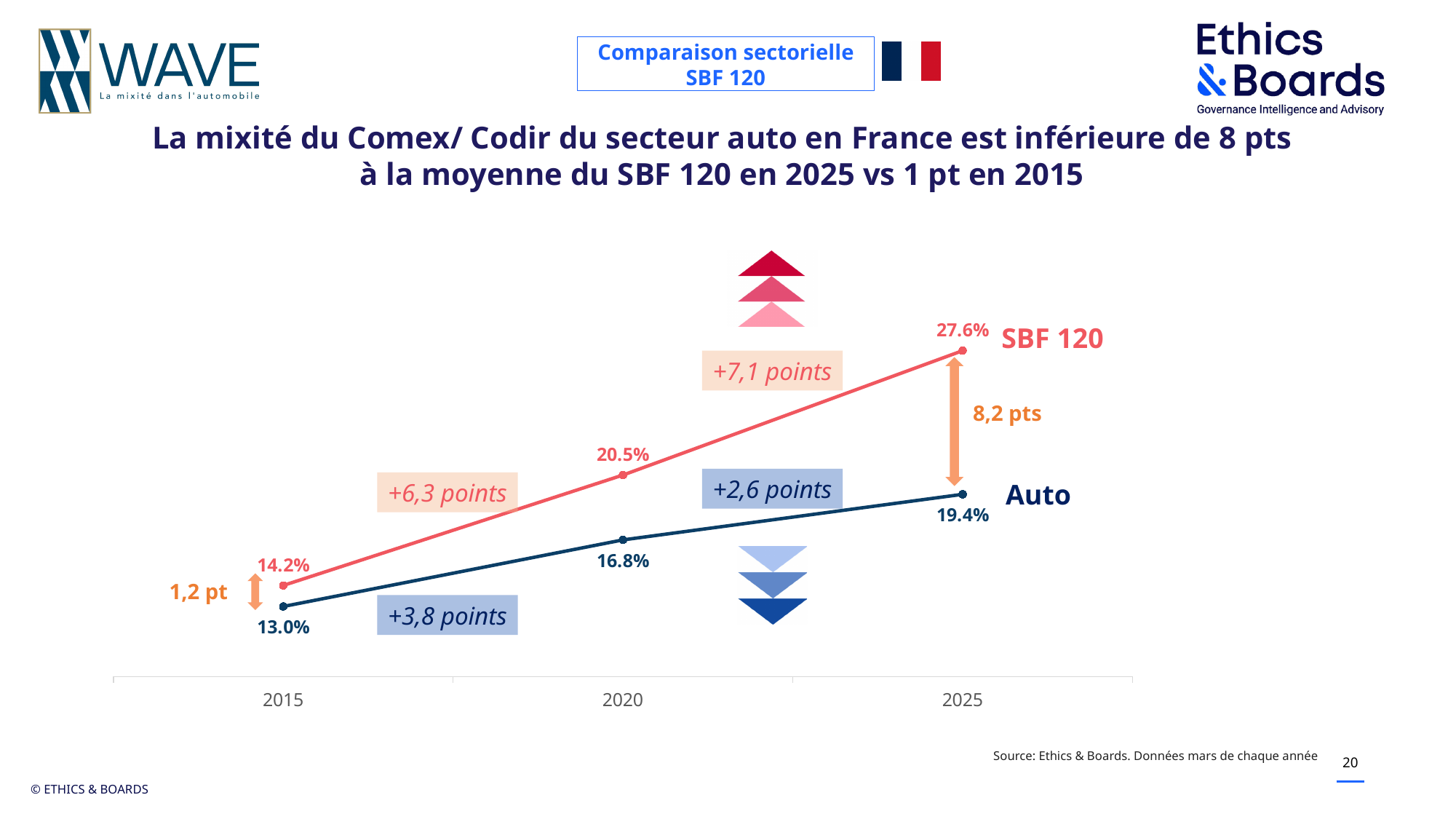
What kind of chart is shown? Line chart What is the SBF 120 value in 2025? 27.6% What is the Auto value in 2020? 16.8% What is the difference between the SBF 120 and Auto values in 2025? 8.2 points Which is larger in 2020, SBF 120 or Auto? SBF 120 How many years are plotted on the x axis? 3 In which year is the SBF 120 series highest? 2025 Does the Auto series rise or fall from 2015 to 2025? Rise In which year is the Auto series lowest? 2015 What is the SBF 120 value in 2015? 14.2% How many series are plotted on the chart? 2 What is the Auto value in 2015? 13.0%